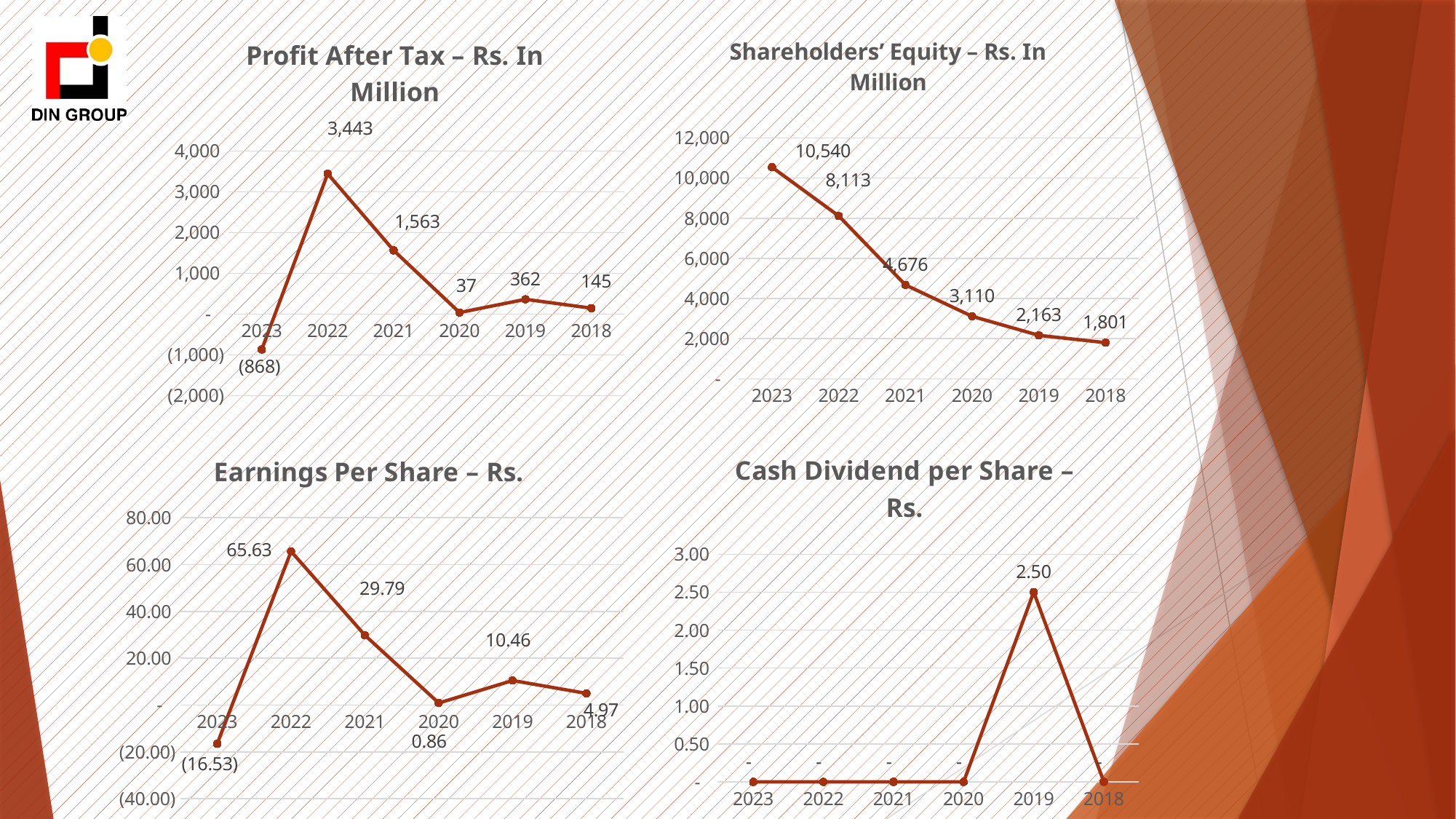
In the Shareholders' Equity chart, what is the difference between the 2023 and 2022 values? 2,427 In the Shareholders' Equity chart, which year has the highest value? 2023 In the Shareholders' Equity chart, do the values rise or fall moving left to right along the x axis from 2023 to 2018? fall How many years are plotted on the x axis of the Cash Dividend per Share chart? 6 In the Profit After Tax chart, what is the difference between the 2021 and 2020 values? 1,526 In the Profit After Tax chart, what is the value for 2022? 3,443 In the Profit After Tax chart, what is the value for 2023? (868) In the Shareholders' Equity chart, what is the value for 2021? 4,676 In the Earnings Per Share chart, which is larger, the value for 2021 or the value for 2018? 2021 In the Cash Dividend per Share chart, what is the value for 2019? 2.50 In the Earnings Per Share chart, what is the value for 2019? 10.46 In the Profit After Tax chart, which year has the lowest value? 2023